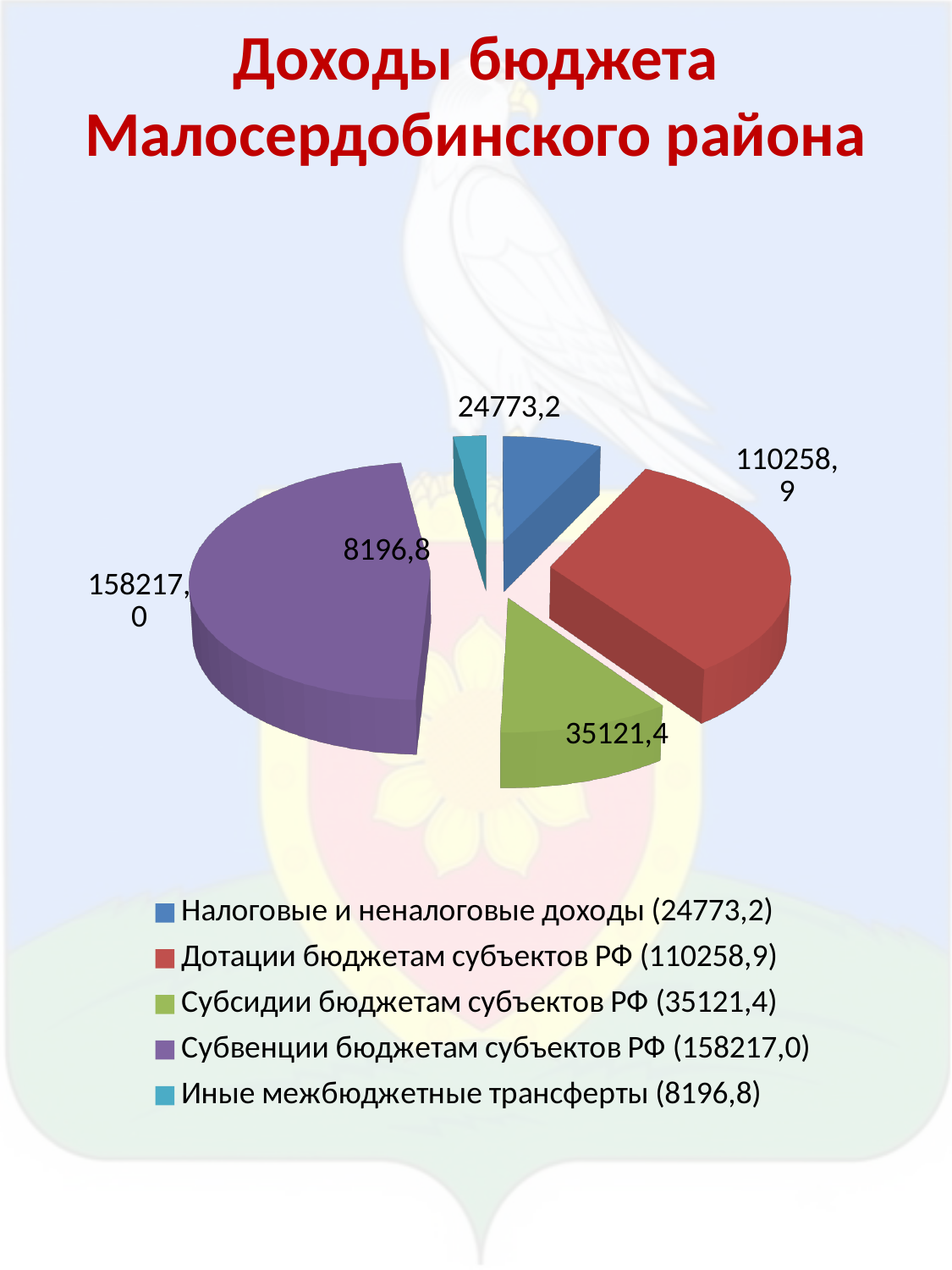
Which category has the largest slice of the pie? Субвенции бюджетам субъектов РФ What kind of chart is shown on the slide? Pie chart What is the value for Налоговые и неналоговые доходы? 24773,2 What is the value for Иные межбюджетные трансферты? 8196,8 Which is larger: Субсидии бюджетам субъектов РФ or Налоговые и неналоговые доходы? Субсидии бюджетам субъектов РФ What colour is the slice for Дотации бюджетам субъектов РФ? Red What is the total of all the slices in the pie chart? 336567,3 Which category has the smallest slice of the pie? Иные межбюджетные трансферты How many slices does the pie chart have? 5 What is the difference between Дотации бюджетам субъектов РФ and Субсидии бюджетам субъектов РФ? 75137,5 What is the difference between Субвенции бюджетам субъектов РФ and Дотации бюджетам субъектов РФ? 47958,1 What is the value for Субвенции бюджетам субъектов РФ? 158217,0